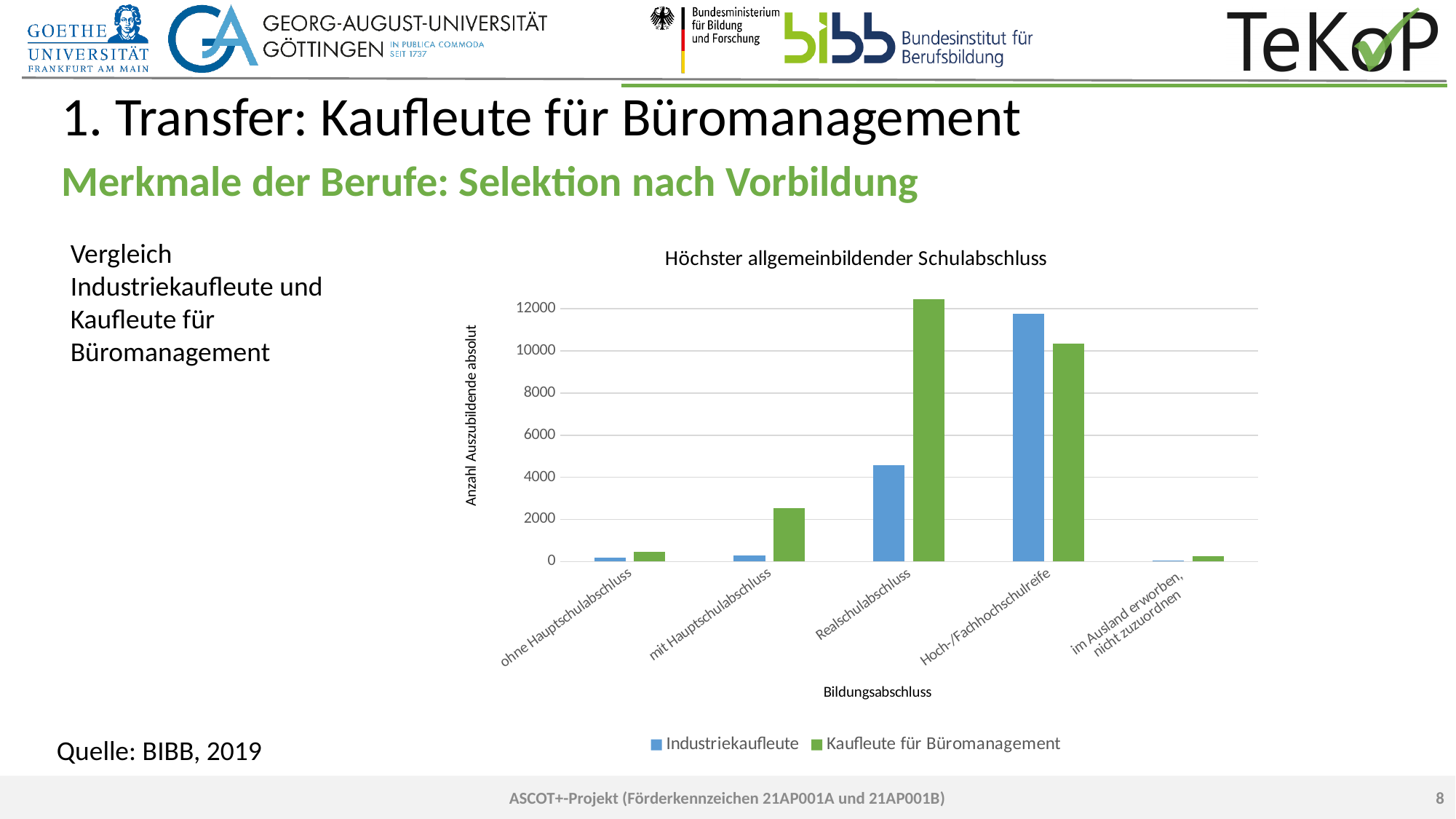
For Realschulabschluss, which series has the larger value: Industriekaufleute or Kaufleute für Büromanagement? Kaufleute für Büromanagement Is the value for Industriekaufleute at Realschulabschluss greater or less than 6000? less How many series does the legend of the chart list? 2 For Hoch-/Fachhochschulreife, which series has the larger value: Industriekaufleute or Kaufleute für Büromanagement? Industriekaufleute What kind of chart is shown on the slide? bar chart Is the value for Industriekaufleute at Hoch-/Fachhochschulreife greater or less than 10000? greater How many categories are shown on the x axis of the chart? 5 Is the value for Kaufleute für Büromanagement at Realschulabschluss greater or less than 12000? greater For the series Industriekaufleute, which category has the highest value? Hoch-/Fachhochschulreife What is the label of the y axis of the chart? Anzahl Auszubildende absolut What is the title of the chart? Höchster allgemeinbildender Schulabschluss For the series Kaufleute für Büromanagement, which category has the highest value? Realschulabschluss